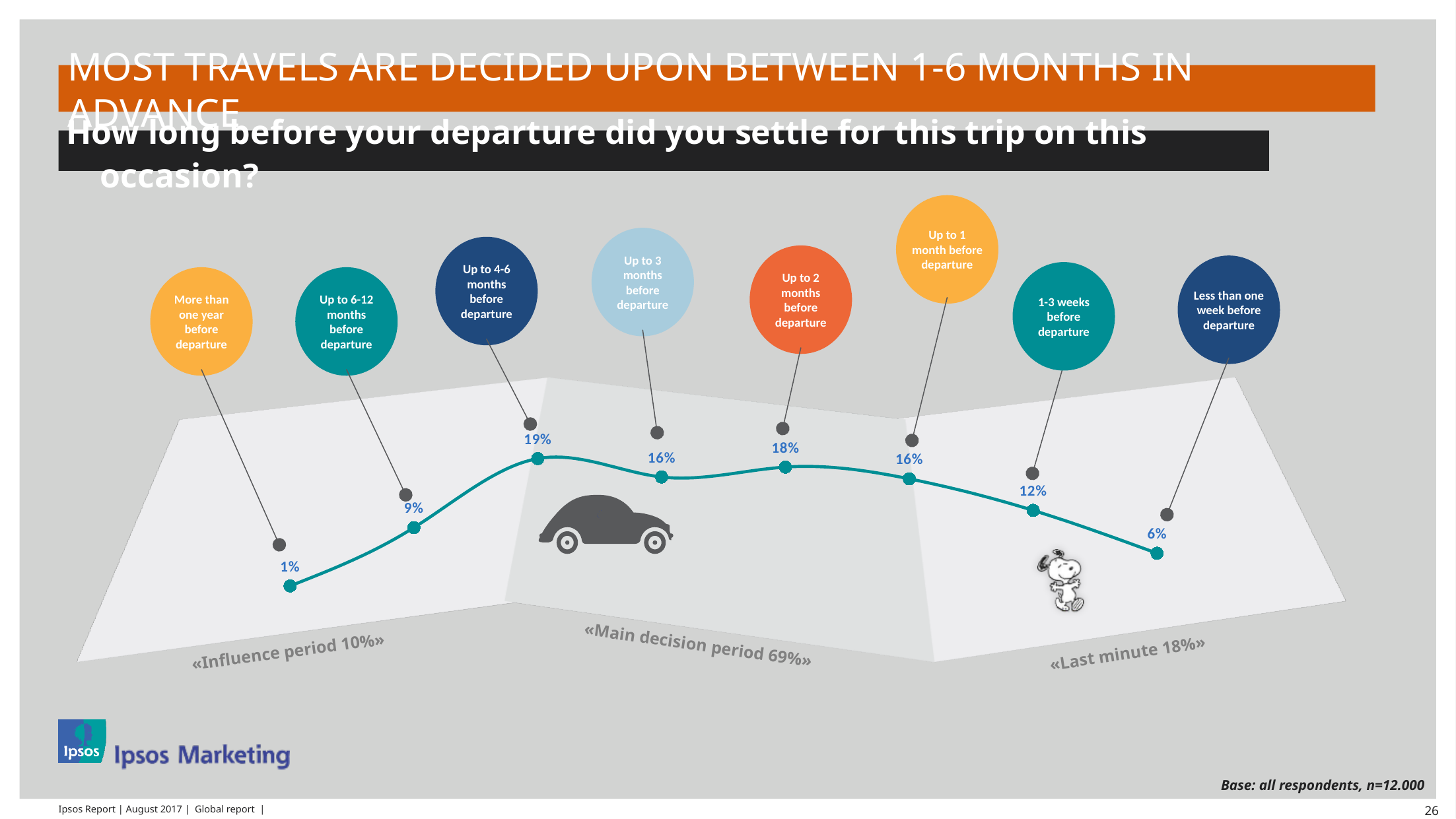
How many time periods are plotted on the chart? 8 Do the values rise or fall from 'Up to 1 month before departure' to 'Less than one week before departure'? Fall Which time period has the highest percentage of respondents? Up to 4-6 months before departure Which time period has the lowest percentage of respondents? More than one year before departure What kind of chart is shown on the slide? Line chart What is the difference between the percentage for up to 2 months before departure and the percentage for up to 3 months before departure? 2% What percentage of respondents settled for the trip less than one week before departure? 6% What percentage of respondents settled for the trip 1-3 weeks before departure? 12% What percentage of respondents settled for the trip more than one year before departure? 1% What percentage is given for the 'Main decision period' label on the chart? 69% What percentage of respondents settled for the trip up to 4-6 months before departure? 19% Which is larger: the percentage for up to 6-12 months before departure or the percentage for 1-3 weeks before departure? 1-3 weeks before departure